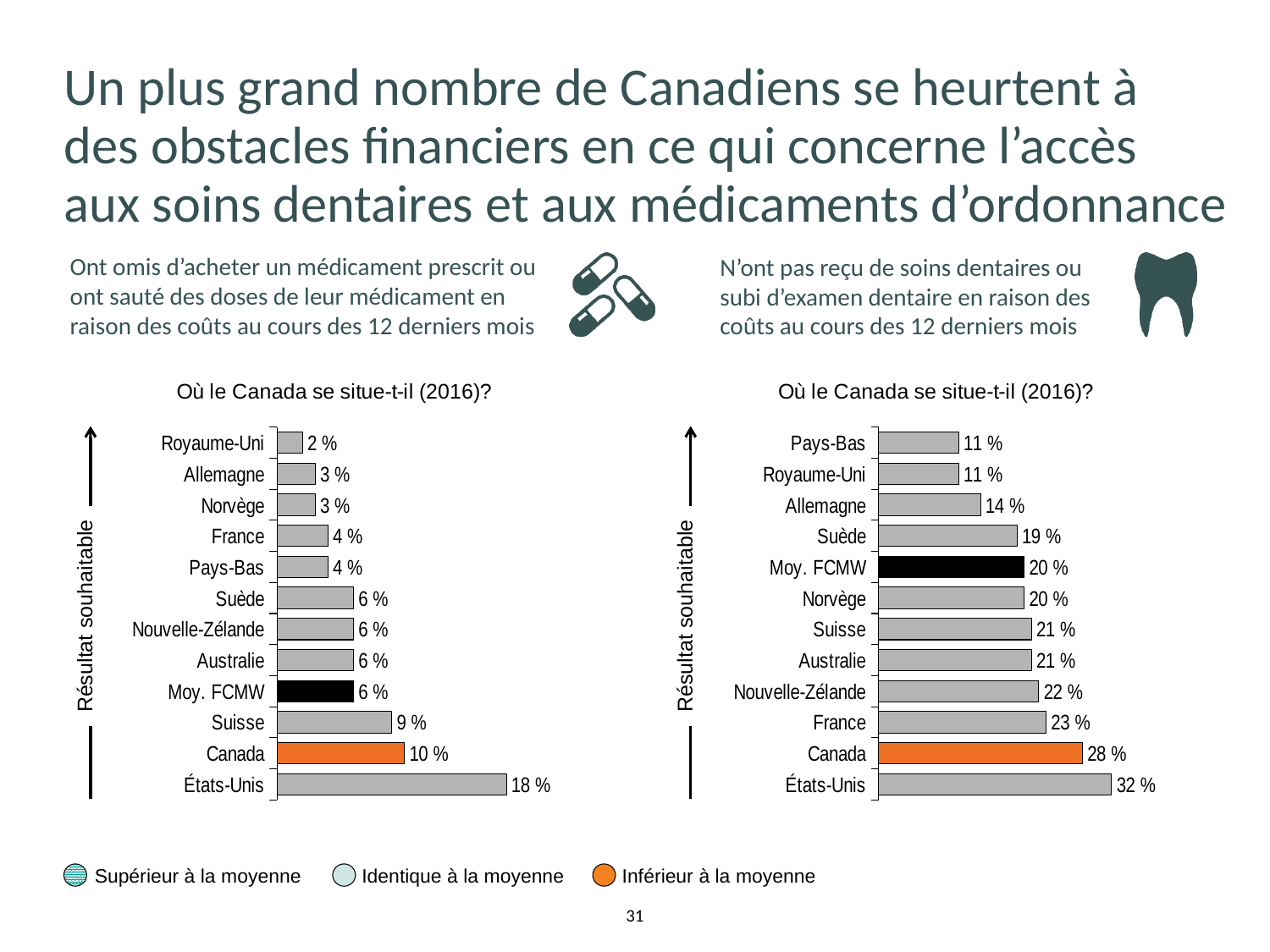
What type of chart is the right chart (dental care)? Bar chart In the left chart (prescription medication), what is the difference between Canada and Moy. FCMW? 4 % In the right chart (dental care), what is the value for Moy. FCMW? 20 % In the left chart (prescription medication), which country has the lowest value? Royaume-Uni In the right chart (dental care), which country has the highest value? États-Unis What colour is the bar for Canada in both charts? Orange In the right chart (dental care), what is the value for Canada? 28 % In the left chart (prescription medication), which country has the highest value? États-Unis In the right chart (dental care), which is larger, the value for France or the value for Suède? France In the left chart (prescription medication), what is the value for Canada? 10 % How many countries or categories are shown in the left chart (prescription medication)? 12 In the right chart (dental care), what is the difference between États-Unis and Canada? 4 %